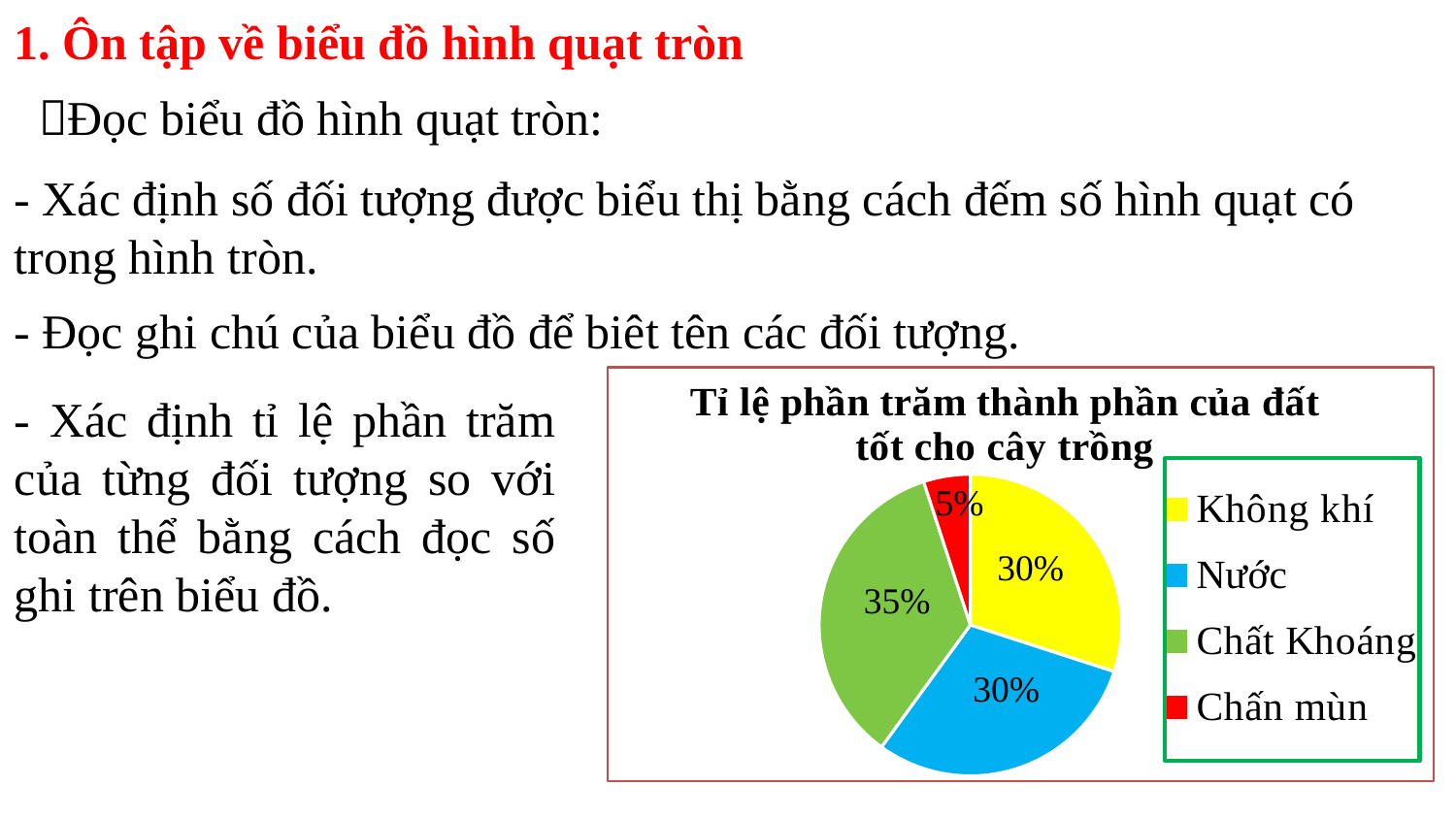
What percentage does the Không khí slice show? 30% Which component has the smallest share of the pie? Chấn mùn What percentage does the Chấn mùn slice show? 5% Which is larger, the share for Chất Khoáng or the share for Nước? Chất Khoáng How many slices does the pie chart have? 4 What colour is the Nước slice in the pie chart? blue Which component has the largest share of the pie? Chất Khoáng What is the difference in percentage points between Chất Khoáng and Chấn mùn? 30 What is the title of the pie chart? Tỉ lệ phần trăm thành phần của đất tốt cho cây trồng What kind of chart is shown on the slide? pie chart What percentage does the Nước slice show? 30% What percentage does the Chất Khoáng slice show? 35%